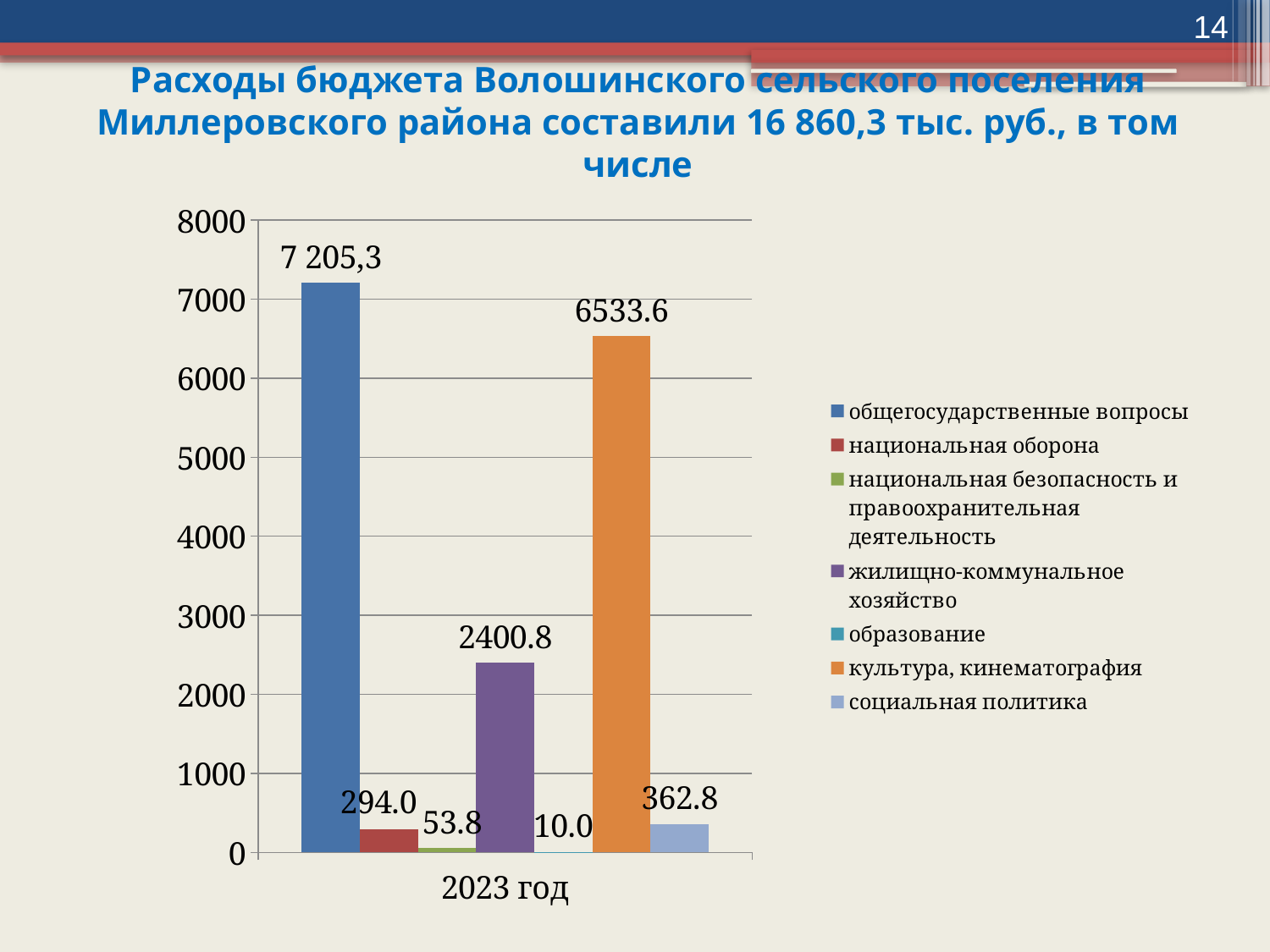
How many series does the legend list? 7 What is the difference between социальная политика and национальная оборона? 68.8 What is the value for жилищно-коммунальное хозяйство? 2400.8 What is the value for общегосударственные вопросы in 2023 год? 7 205,3 What is the difference between культура, кинематография and жилищно-коммунальное хозяйство? 4132.8 Which is larger, национальная оборона or социальная политика? социальная политика What is the value for культура, кинематография? 6533.6 What is the label on the x axis under the bars? 2023 год What is the value for образование? 10.0 Which series has the lowest value? образование Which series has the highest value? общегосударственные вопросы What kind of chart is shown on the slide? bar chart